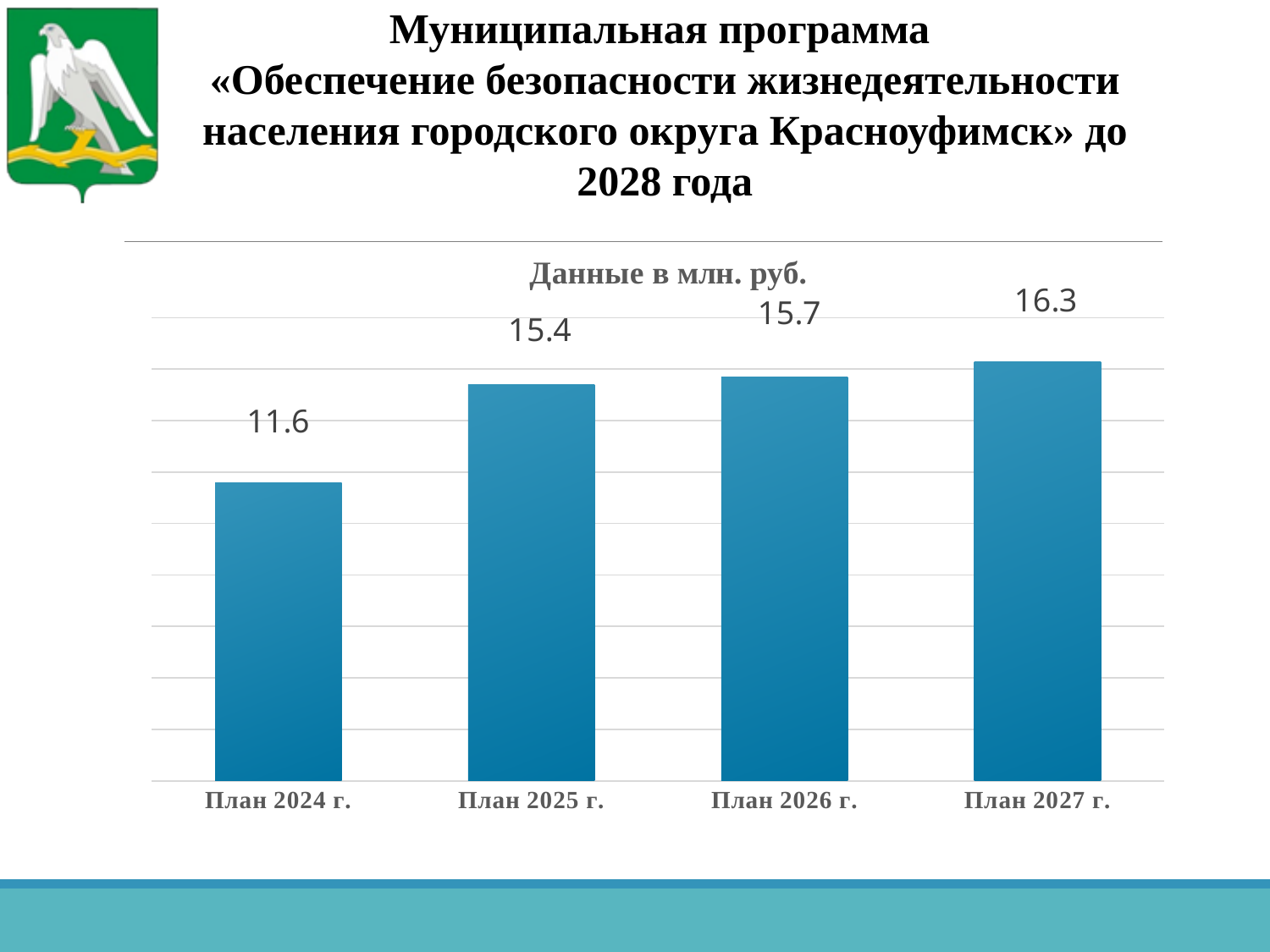
What is the difference between the values for План 2027 г. and План 2024 г.? 4.7 What is the value for План 2025 г.? 15.4 What kind of chart is shown on the slide? Bar chart How many categories are shown on the x axis? 4 What is the value for План 2027 г.? 16.3 Which category has the lowest value? План 2024 г. Which category has the highest value? План 2027 г. What is the value for План 2026 г.? 15.7 What is the difference between the values for План 2026 г. and План 2025 г.? 0.3 What is the value for План 2024 г.? 11.6 Which is larger, the value for План 2025 г. or the value for План 2024 г.? План 2025 г. Do the values rise or fall from План 2024 г. to План 2027 г.? Rise